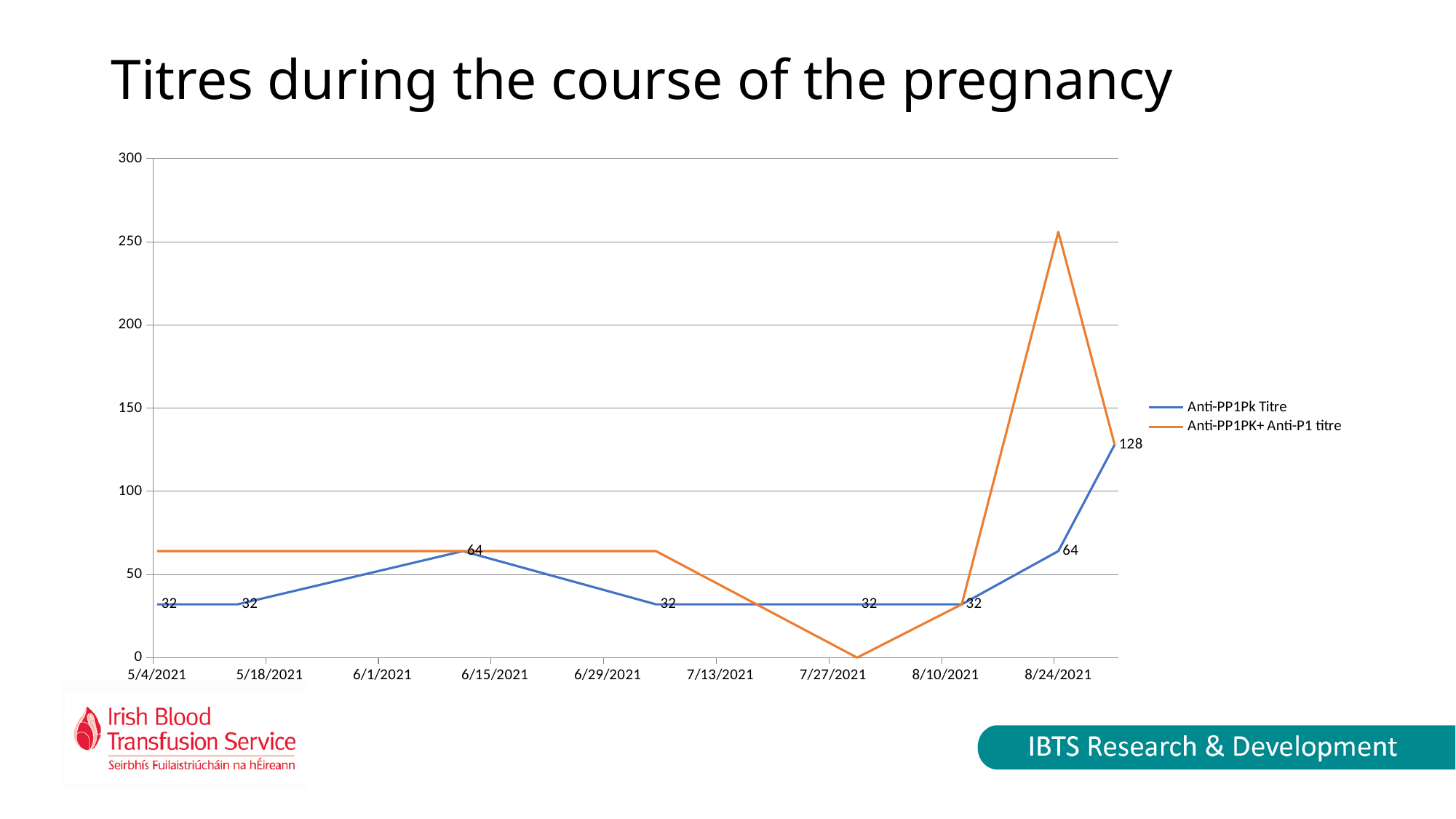
What are the two series named in the legend? Anti-PP1Pk Titre and Anti-PP1PK+ Anti-P1 titre Around 8/24/2021, which series has the higher value? Anti-PP1PK+ Anti-P1 titre What is the first labelled value of the Anti-PP1Pk Titre series, at 5/4/2021? 32 What is the difference between the last labelled value (128) and the first labelled value (32) of the Anti-PP1Pk Titre series? 96 How many series does the legend list? 2 What kind of chart is shown on the slide? line chart What is the highest labelled value of the Anti-PP1Pk Titre series? 128 How many labelled data points does the Anti-PP1Pk Titre series have? 8 What is the lowest labelled value of the Anti-PP1Pk Titre series? 32 What is the final labelled value of the Anti-PP1Pk Titre series? 128 Is the peak value of the Anti-PP1PK+ Anti-P1 titre series greater or less than 200? greater What is the title of the chart? Titres during the course of the pregnancy